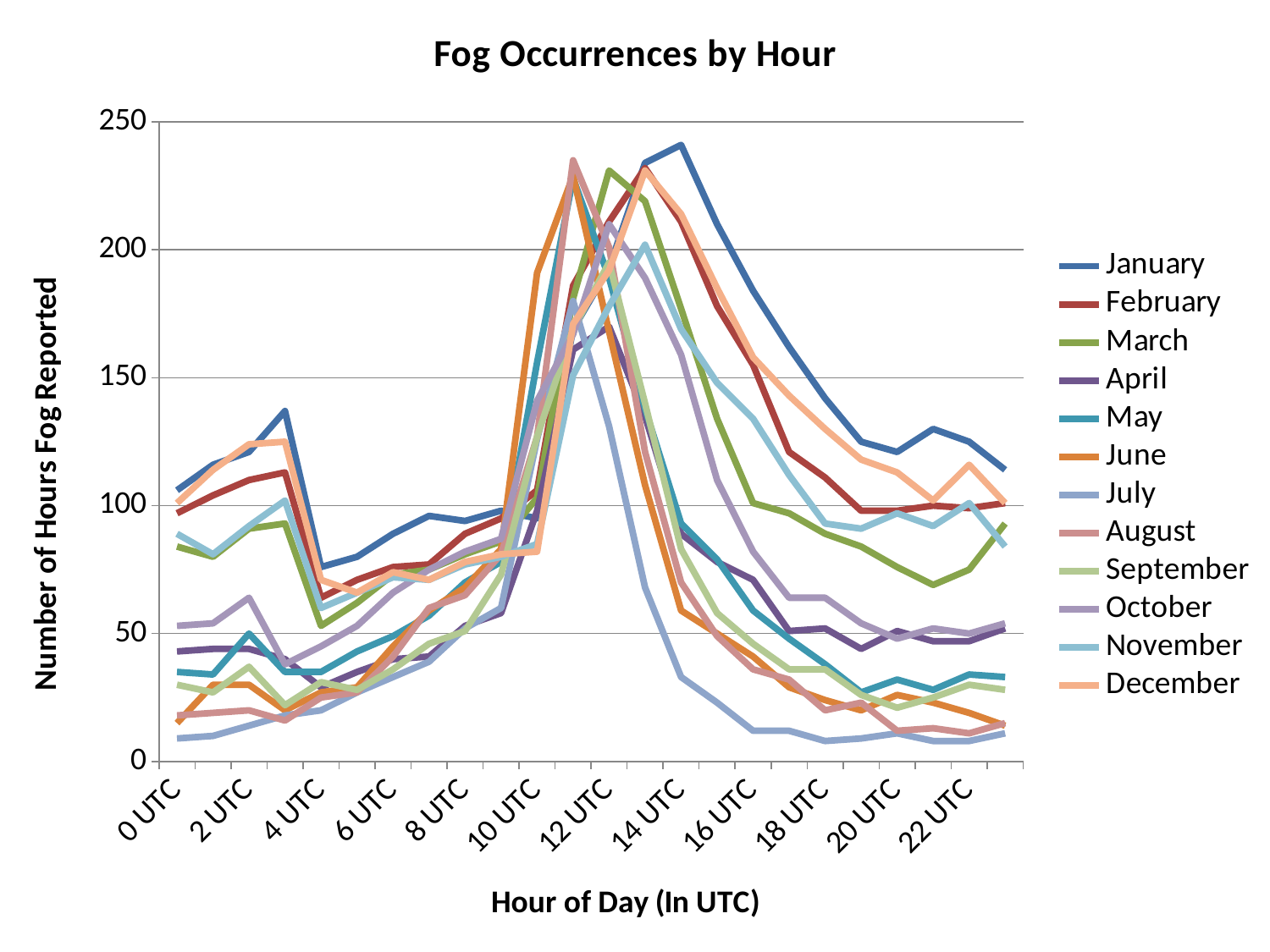
Which month has the lowest value at 18 UTC? July What is the label of the vertical axis? Number of Hours Fog Reported At 0 UTC, which is larger: the value for January or the value for July? January Is the value for March at 14 UTC greater or less than 200? less What kind of chart is shown on the slide? line chart What is the title of the chart? Fog Occurrences by Hour Is the value for July at 0 UTC greater or less than 50? less How many series does the legend list? 12 Which month has the highest value at 16 UTC? January Is the value for June at 10 UTC greater or less than 150? greater At 18 UTC, which is larger: the value for January or the value for April? January